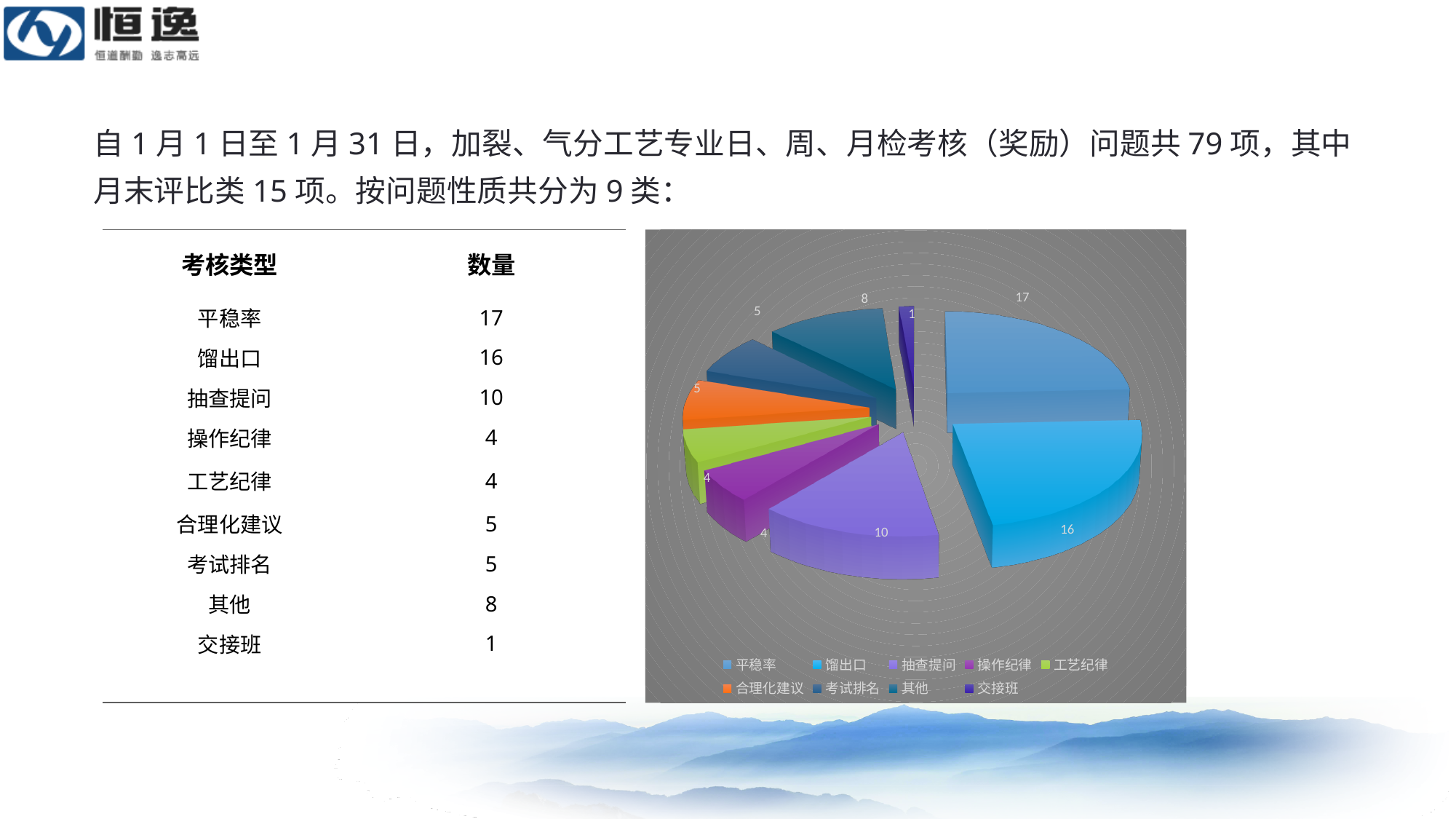
What is the value for 馏出口 in the pie chart? 16 Which category has the smallest slice in the pie chart? 交接班 What colour is the 合理化建议 slice in the pie chart? orange What is the value for 其他 in the pie chart? 8 What is the difference between the values for 平稳率 and 抽查提问 in the pie chart? 7 How many categories does the pie chart have? 9 How many entries does the pie chart's legend list? 9 What is the value for 平稳率 in the pie chart? 17 What kind of chart is shown on the slide? pie chart Which is larger in the pie chart, 其他 or 合理化建议? 其他 Which category has the largest slice in the pie chart? 平稳率 What is the value for 抽查提问 in the pie chart? 10